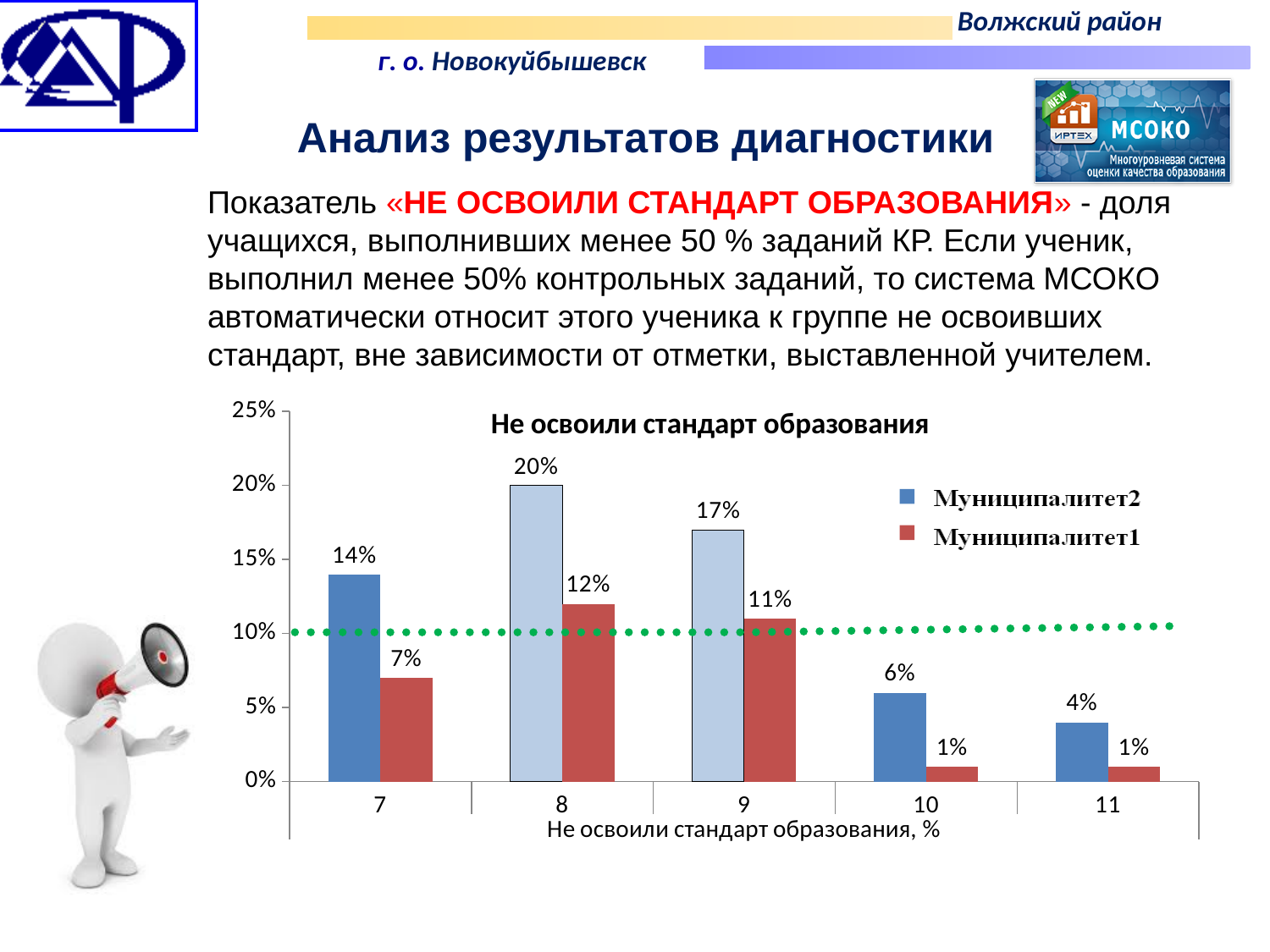
Is the value for Муниципалитет2 in category 10 greater or less than 10%? less How many categories are shown on the x axis? 5 What is the value for Муниципалитет2 in category 8? 20% What kind of chart is shown on the slide? bar chart What is the difference between Муниципалитет2 and Муниципалитет1 in category 9? 6% Which is larger in category 10: Муниципалитет2 or Муниципалитет1? Муниципалитет2 What is the value for Муниципалитет1 in category 7? 7% Which category has the lowest value for Муниципалитет2? 11 What is the title of the chart? Не освоили стандарт образования How many series does the legend list? 2 Which category has the highest value for Муниципалитет2? 8 What is the value for Муниципалитет1 in category 9? 11%